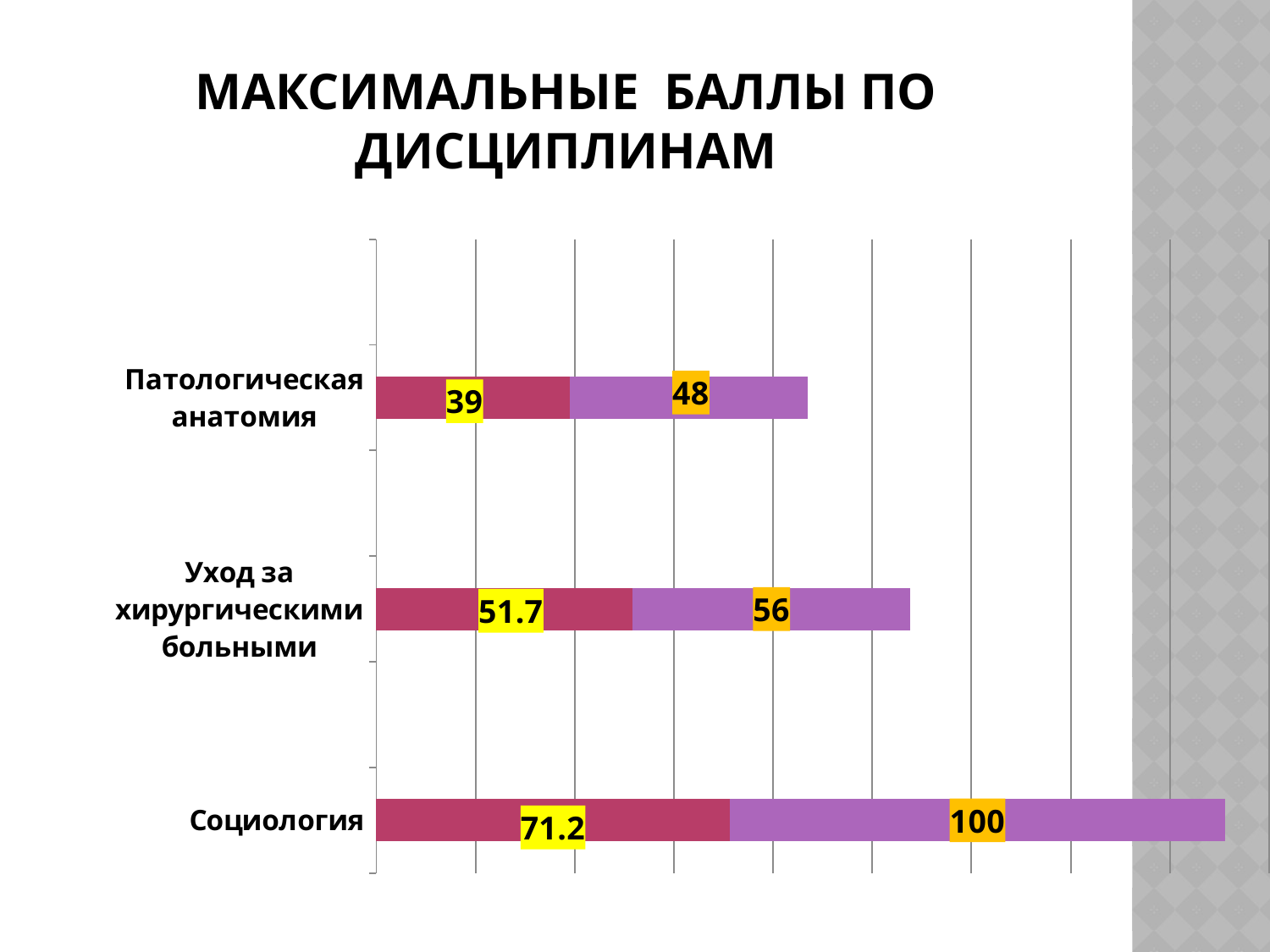
Which is larger: the red segment for Уход за хирургическими больными or the red segment for Патологическая анатомия? Уход за хирургическими больными What is the value of the red (crimson) segment for Социология? 71.2 What is the total of the stacked bar for Патологическая анатомия? 87 Which discipline has the lowest value in the red (crimson) segment? Патологическая анатомия What is the value of the red (crimson) segment for Уход за хирургическими больными? 51.7 What is the value of the purple segment for Социология? 100 What is the title of the slide? МАКСИМАЛЬНЫЕ БАЛЛЫ ПО ДИСЦИПЛИНАМ What kind of chart is shown on the slide? bar chart What is the value of the purple segment for Патологическая анатомия? 48 For Социология, what is the difference between the purple segment value and the red segment value? 28.8 How many categories (disciplines) are shown on the chart? 3 Which discipline has the highest value in the purple segment? Социология